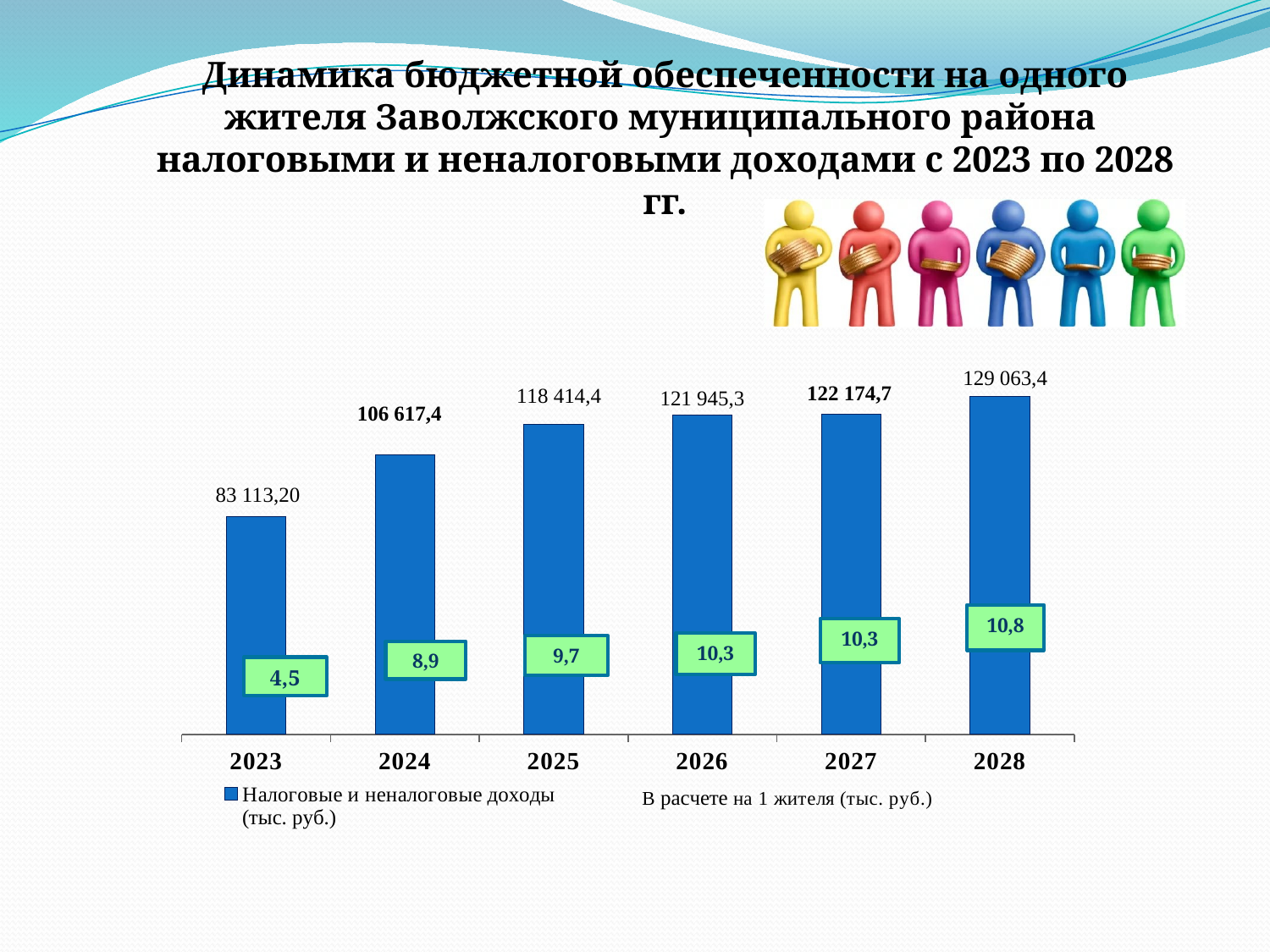
What is the per-resident value (В расчете на 1 жителя) shown for 2025? 9,7 What is the per-resident value shown for 2024? 8,9 What is the difference between the tax and non-tax revenues for 2028 and 2023? 45 950,2 Which year has the highest tax and non-tax revenues? 2028 What kind of chart is shown on the slide? bar chart Do the tax and non-tax revenues rise or fall from 2023 to 2028? rise Which year has the lowest per-resident value? 2023 What is the value of tax and non-tax revenues (Налоговые и неналоговые доходы) for 2023? 83 113,20 Which year has larger tax and non-tax revenues, 2026 or 2027? 2027 How many years are shown on the x axis of the chart? 6 What is the value of tax and non-tax revenues for 2028? 129 063,4 What is the difference between the per-resident values for 2028 and 2023? 6,3